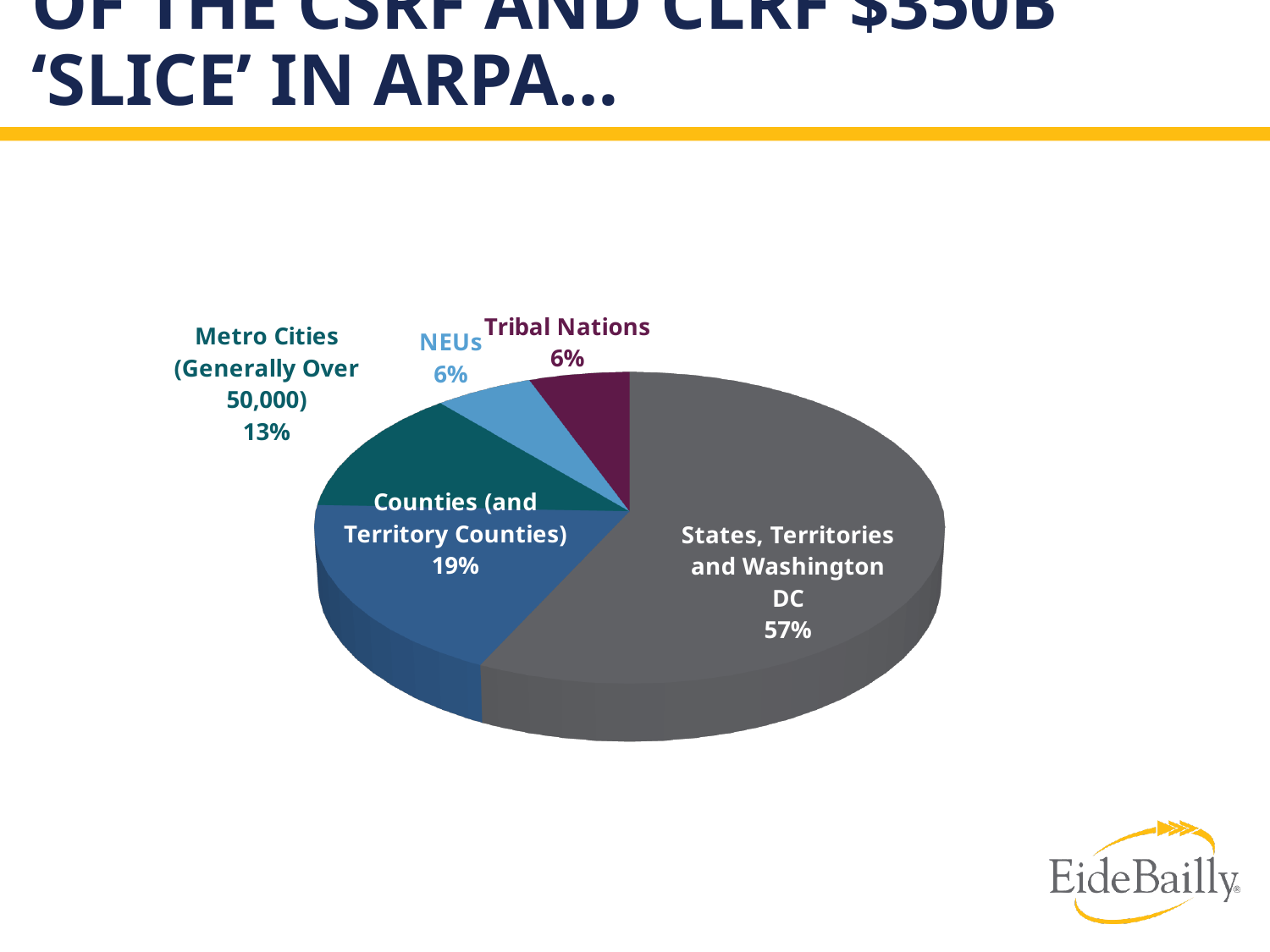
Which category has the largest slice of the pie? States, Territories and Washington DC What colour is the slice for Tribal Nations? Dark purple (maroon) What is the difference in percentage points between Metro Cities (Generally Over 50,000) and Tribal Nations? 7 percentage points What is the difference in percentage points between States, Territories and Washington DC and Counties (and Territory Counties)? 38 percentage points What percentage is shown for NEUs? 6% What percentage is shown for Metro Cities (Generally Over 50,000)? 13% What kind of chart is shown on the slide? Pie chart What share of the pie goes to States, Territories and Washington DC? 57% How many slices does the pie chart have? 5 What percentage is shown for Counties (and Territory Counties)? 19% What percentage is shown for Tribal Nations? 6% Which is larger, the share for Counties (and Territory Counties) or the share for Metro Cities (Generally Over 50,000)? Counties (and Territory Counties)